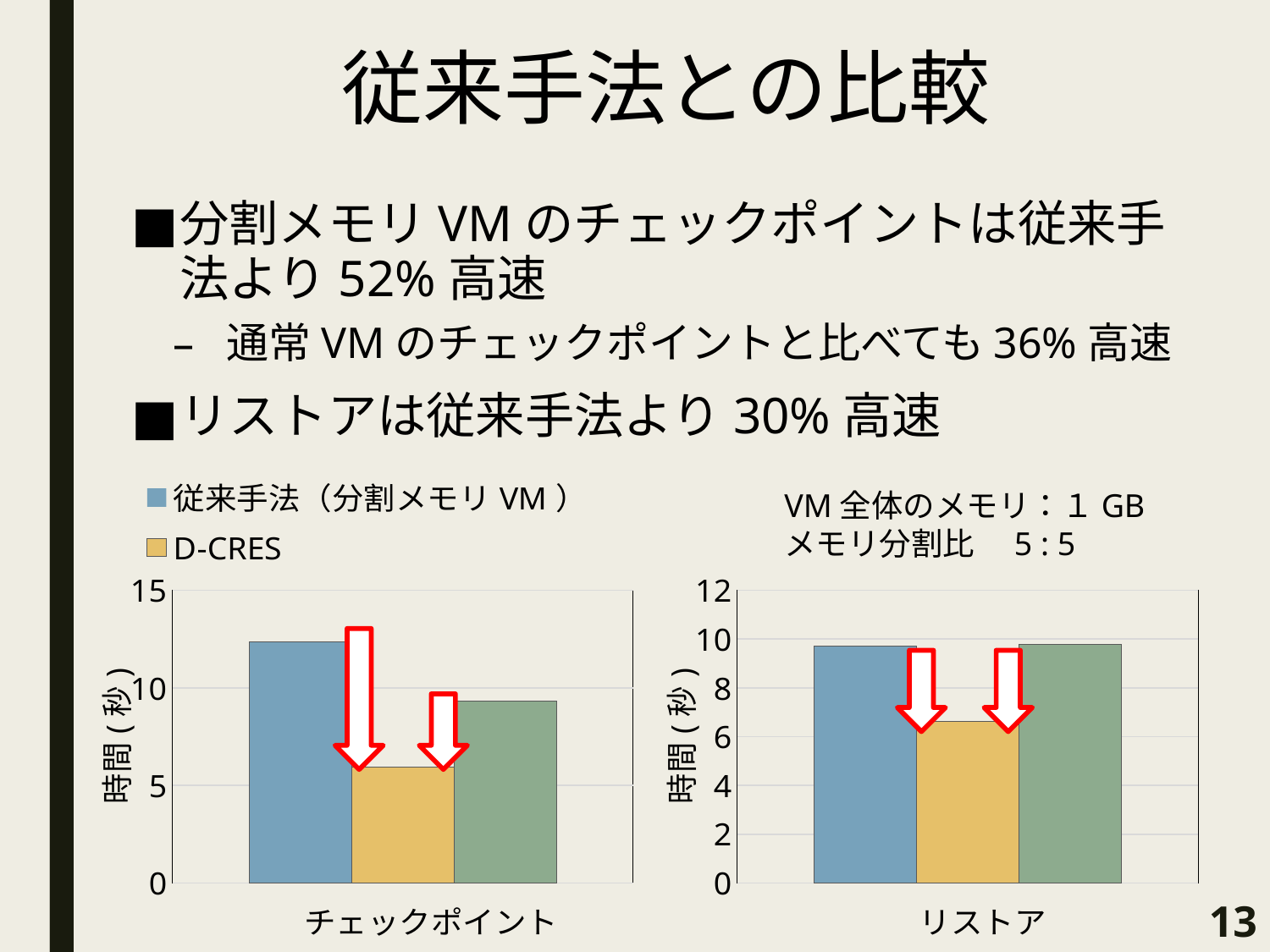
What is the y-axis label of the リストア chart? 時間 ( 秒 ) In the リストア chart, which is larger, the bar for 従来手法（分割メモリ VM） or the bar for D-CRES? 従来手法（分割メモリ VM） In the チェックポイント chart, which of the legend series has the lowest bar? D-CRES In the チェックポイント chart, is the value for D-CRES greater or less than 5? greater What is the highest tick value on the y-axis of the リストア chart? 12 In the リストア chart, is the value for 従来手法（分割メモリ VM） greater or less than 8? greater In the チェックポイント chart, which is larger, the bar for 従来手法（分割メモリ VM） or the bar for D-CRES? 従来手法（分割メモリ VM） In the リストア chart, is the value for D-CRES greater or less than 8? less What kind of chart is the チェックポイント chart on the left? bar chart In the チェックポイント chart, how many bars are plotted? 3 How many series does the legend above the charts list? 2